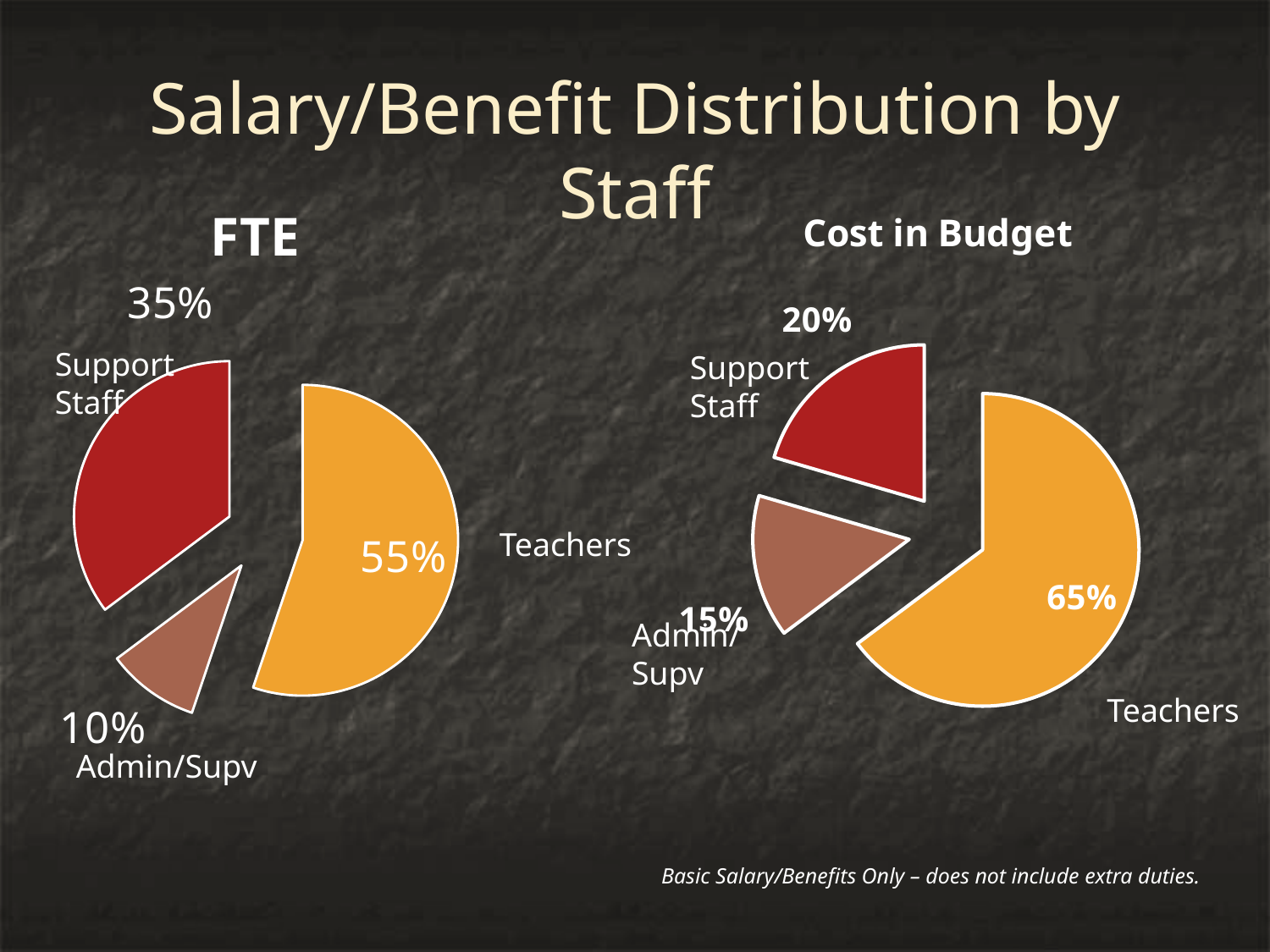
In the Cost in Budget chart, what share of the pie is Admin/Supv? 15% In the FTE chart, what share of the pie is Support Staff? 35% In the FTE chart, which category has the largest slice? Teachers What kind of chart is the FTE chart? Pie chart In the Cost in Budget chart, which category has the smallest slice? Admin/Supv In the FTE chart, what share of the pie is Teachers? 55% In the FTE chart, what is the difference between the Support Staff share and the Admin/Supv share? 25% How many categories does the Cost in Budget chart show? 3 Is the Teachers share larger in the FTE chart or in the Cost in Budget chart? Cost in Budget